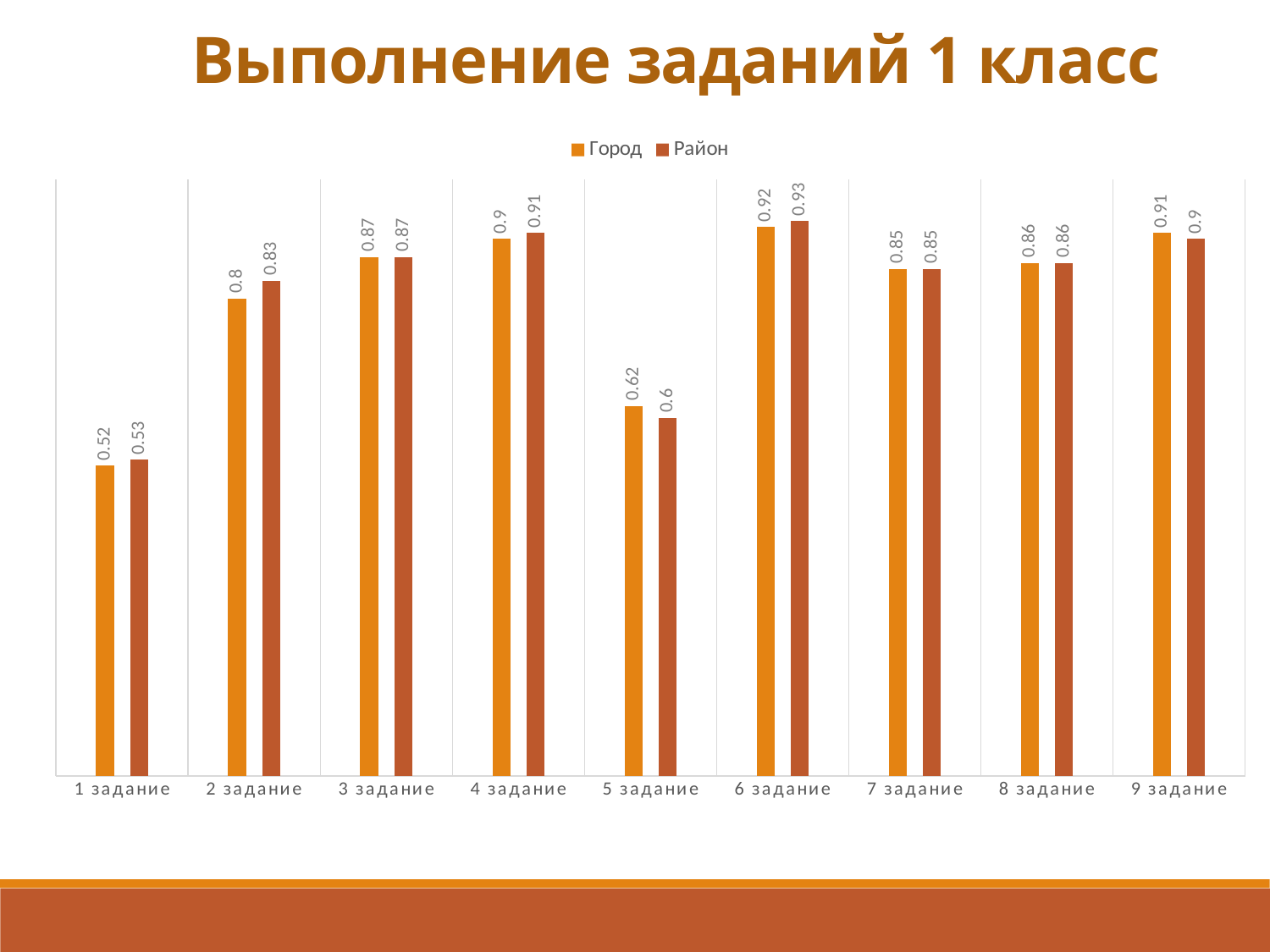
What are the two series named in the legend? Город and Район How many series does the legend list? 2 Which task has the highest value for Город? 6 задание Which task has the lowest value for Район? 1 задание How many tasks are shown on the x axis? 9 What is the difference between the Район and Город values on 2 задание? 0.03 What is the value for Город on 1 задание? 0.52 What kind of chart is shown on the slide? bar chart What is the value for Район on 6 задание? 0.93 Which is larger on 5 задание, Город or Район? Город What is the title of the slide? Выполнение заданий 1 класс What is the value for Район on 5 задание? 0.6